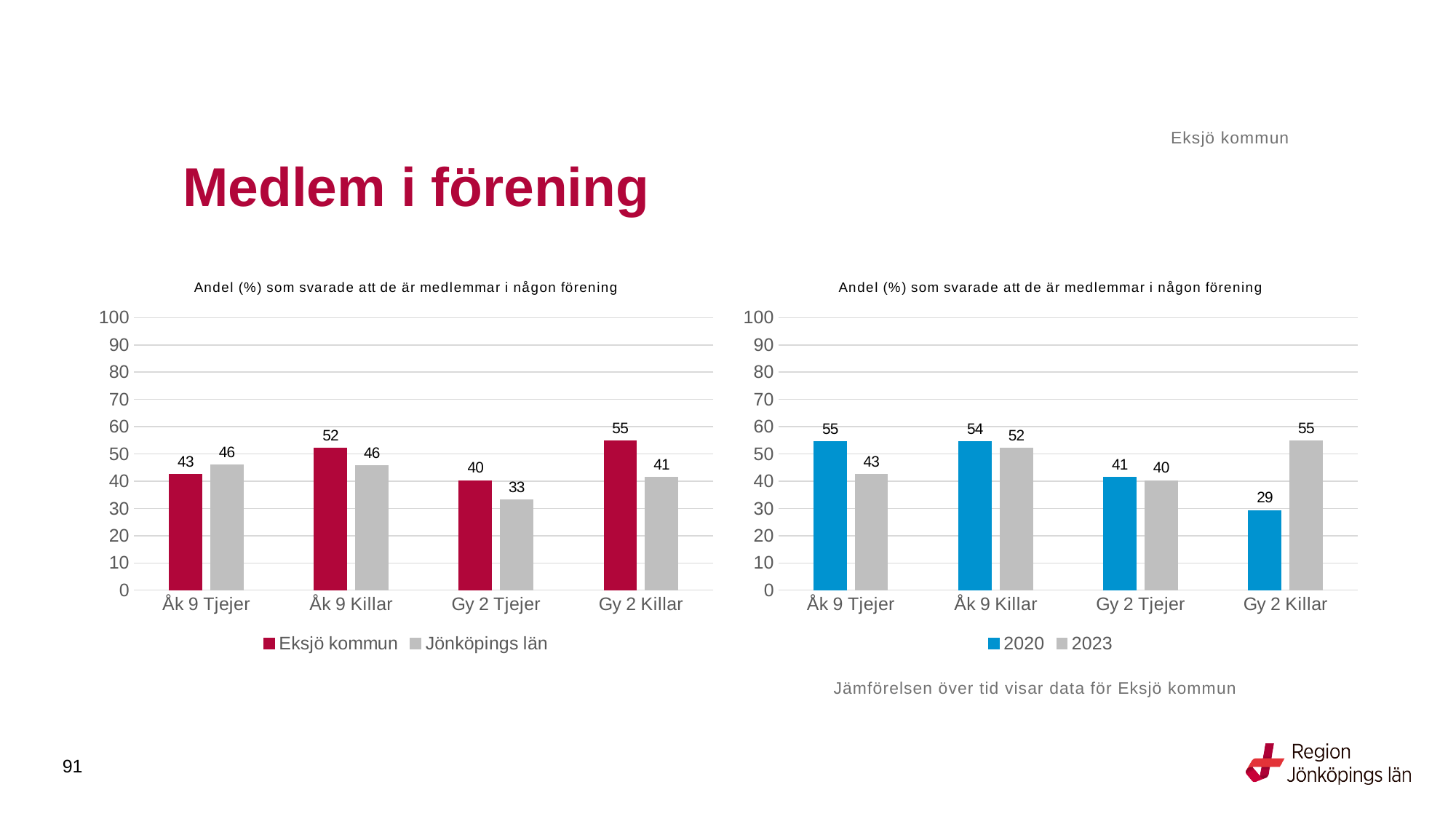
In the right chart, which category has the lowest value for 2020? Gy 2 Killar In the right chart, what is the difference between 2023 and 2020 for Gy 2 Killar? 26 In the left chart, what is the value for Jönköpings län for Gy 2 Tjejer? 33 In the left chart, which category has the highest value for Eksjö kommun? Gy 2 Killar In the left chart, which is larger for Åk 9 Tjejer: Eksjö kommun or Jönköpings län? Jönköpings län In the right chart, what is the value for 2023 for Åk 9 Killar? 52 How many categories are shown on the x axis of the right chart? 4 How many series does the legend of the left chart list? 2 What type of chart is the right chart? Bar chart In the left chart, what is the difference between Eksjö kommun and Jönköpings län for Gy 2 Killar? 14 In the right chart, what is the value for 2020 for Gy 2 Killar? 29 In the left chart, what is the value for Eksjö kommun for Gy 2 Killar? 55